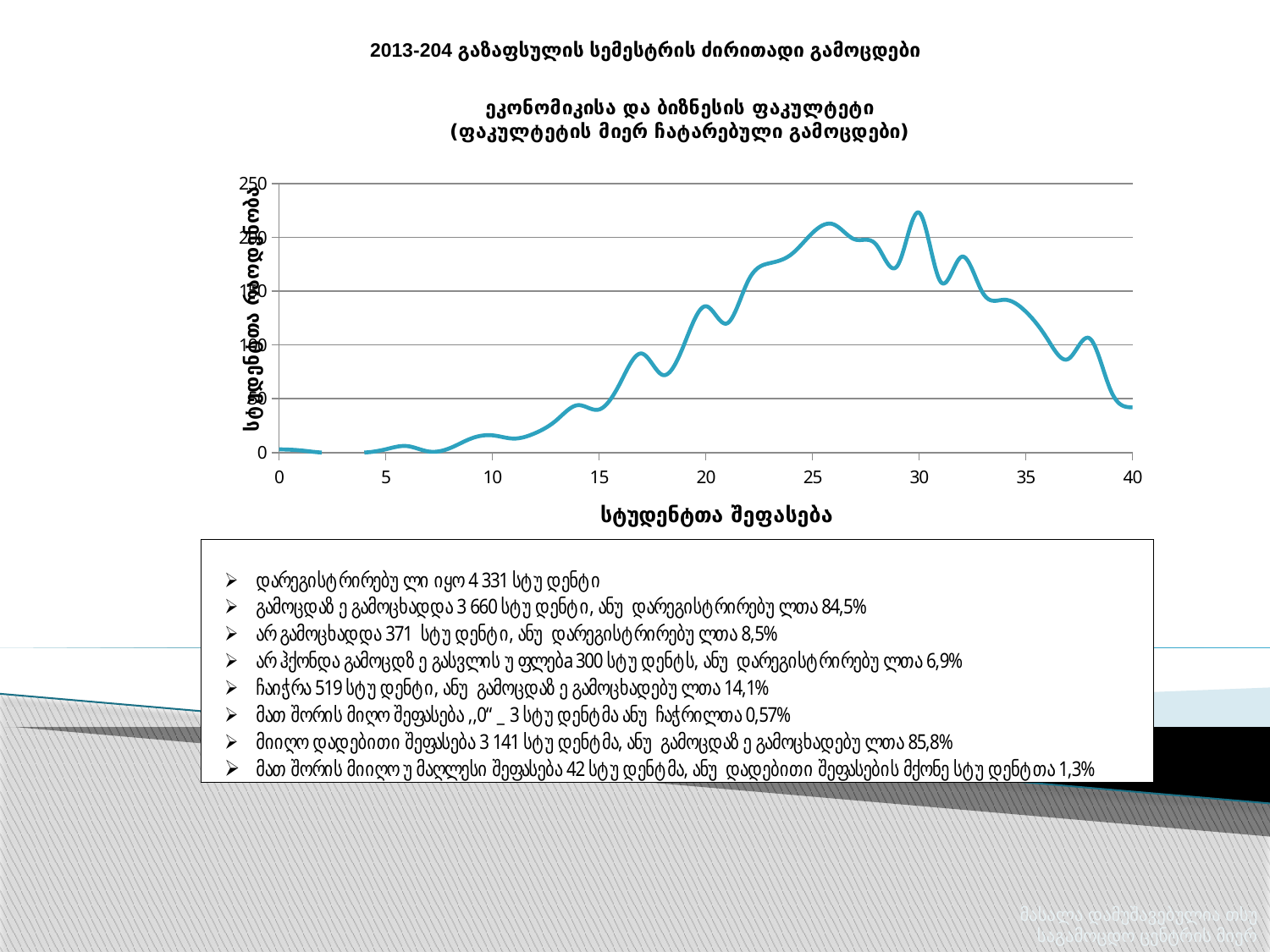
What kind of chart is shown on the slide? line chart Is the value of the line at x = 25 greater or less than 150? greater Is the value of the line at x = 40 greater or less than 50? less Is the value of the line at x = 20 greater or less than 100? greater Does the line generally rise or fall between x = 32 and x = 40? fall Does the line generally rise or fall between x = 10 and x = 25? rise What is the title of the chart? სტუდენტთა შეფასება